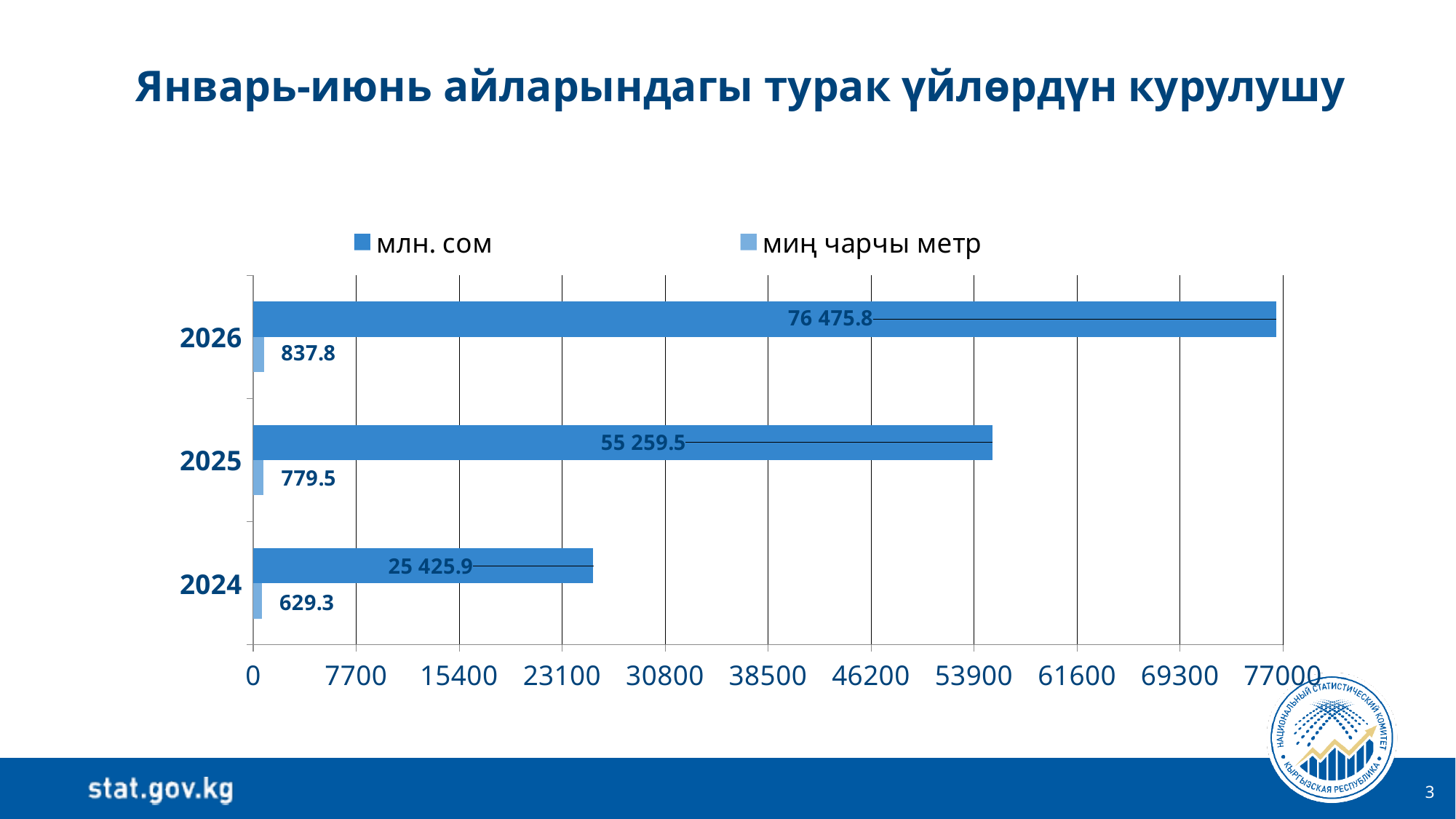
What is the value for млн. сом in 2026? 76 475.8 What is the value for млн. сом in 2025? 55 259.5 Which year has the highest value for млн. сом? 2026 What is the value for миң чарчы метр in 2025? 779.5 Which year has the lowest value for миң чарчы метр? 2024 What kind of chart is shown on the slide? Bar chart How many series does the legend list? 2 Which is larger: the млн. сом value for 2024 or for 2025? 2025 How many years are shown on the chart? 3 What is the value for миң чарчы метр in 2024? 629.3 What is the difference between the миң чарчы метр values for 2025 and 2024? 150.2 What is the difference between the млн. сом values for 2026 and 2025? 21 216.3